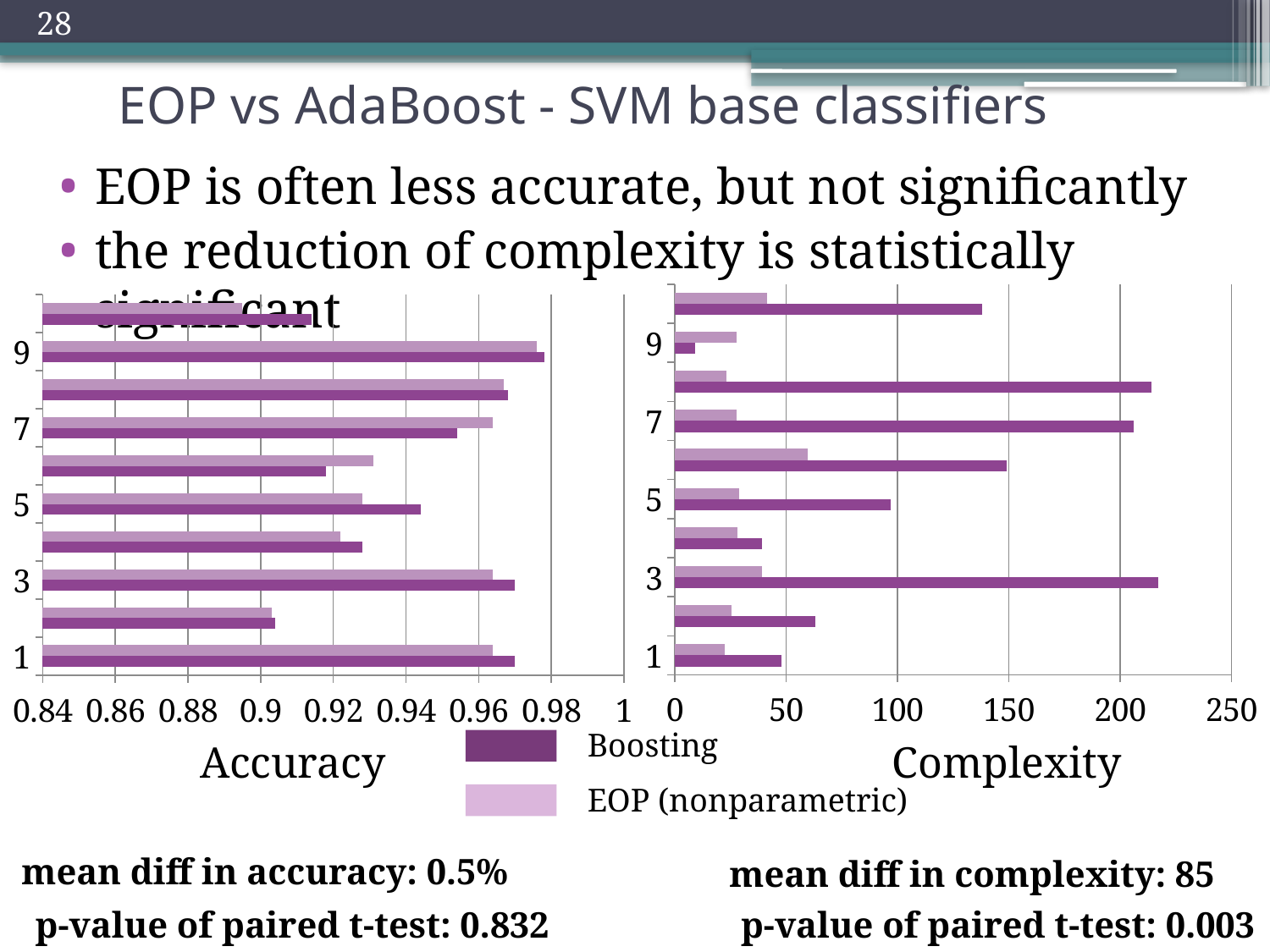
In the Complexity chart, is the EOP (nonparametric) value for category 3 greater or less than 50? less What are the two series named in the legend? Boosting and EOP (nonparametric) In the Accuracy chart, for category 5, which series has the larger value, Boosting or EOP (nonparametric)? Boosting In the Complexity chart, how many categories are plotted on the y axis? 10 In the Accuracy chart, which category has the lowest Boosting value? 2 In the Accuracy chart, is the Boosting value for category 7 greater or less than 0.96? less In the Complexity chart, which category has the lowest Boosting value? 9 In the Complexity chart, is the Boosting value for category 3 greater or less than 200? greater How many series does the legend list? 2 What kind of chart is the Accuracy chart? bar chart In the Complexity chart, for category 3, which series has the larger value, Boosting or EOP (nonparametric)? Boosting